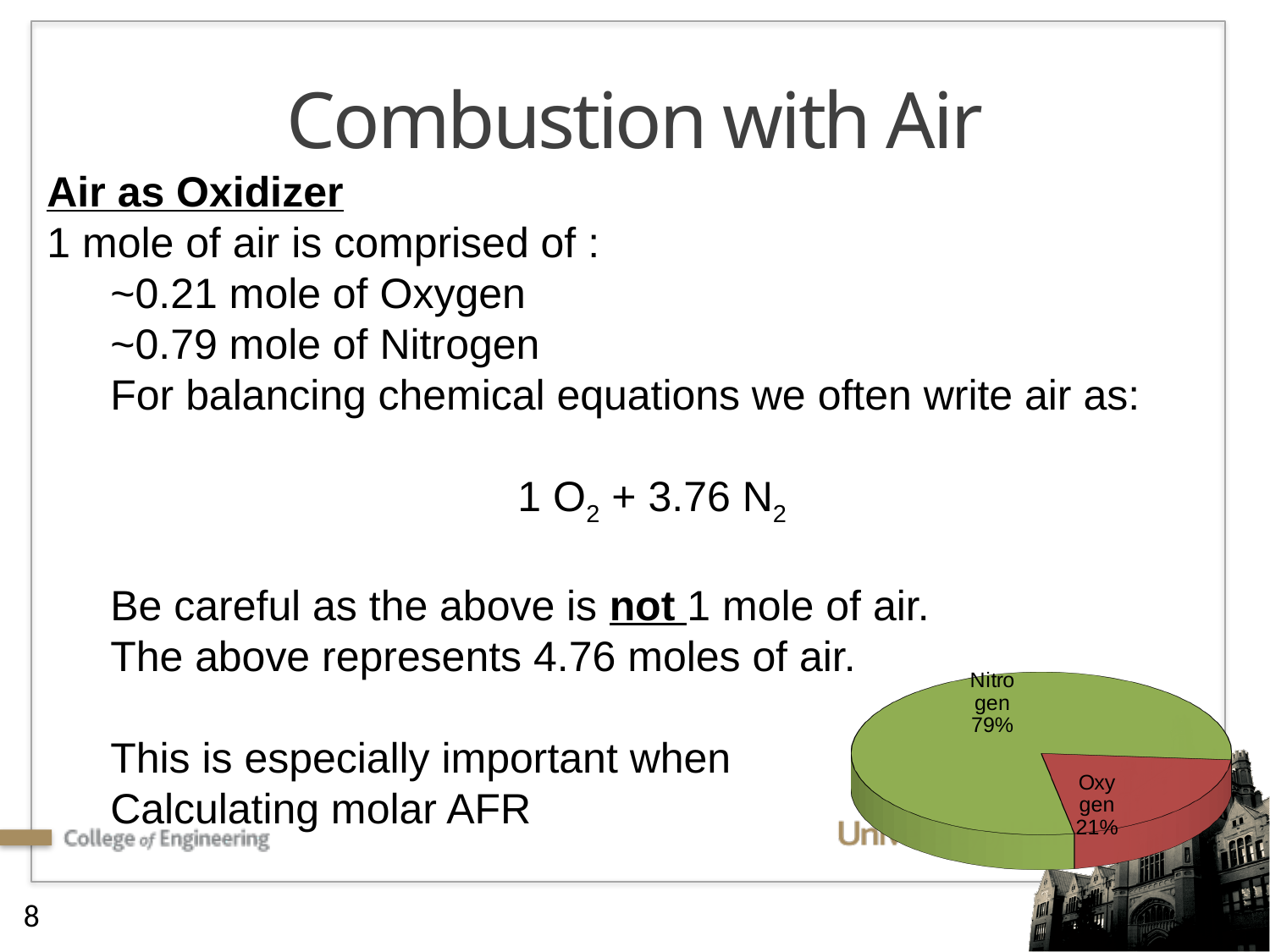
What colour is the Oxygen slice of the pie chart? red How many slices does the pie chart have? 2 What percentage of the pie chart is Oxygen? 21% What is the difference in percentage points between the Nitrogen and Oxygen slices? 58 Which is larger in the pie chart, Nitrogen or Oxygen? Nitrogen What is the combined share of the Nitrogen and Oxygen slices? 100% What kind of chart is shown on the slide? pie chart What colour is the Nitrogen slice of the pie chart? green Which slice of the pie chart is the largest? Nitrogen What percentage of the pie chart is Nitrogen? 79% Which slice of the pie chart is the smallest? Oxygen